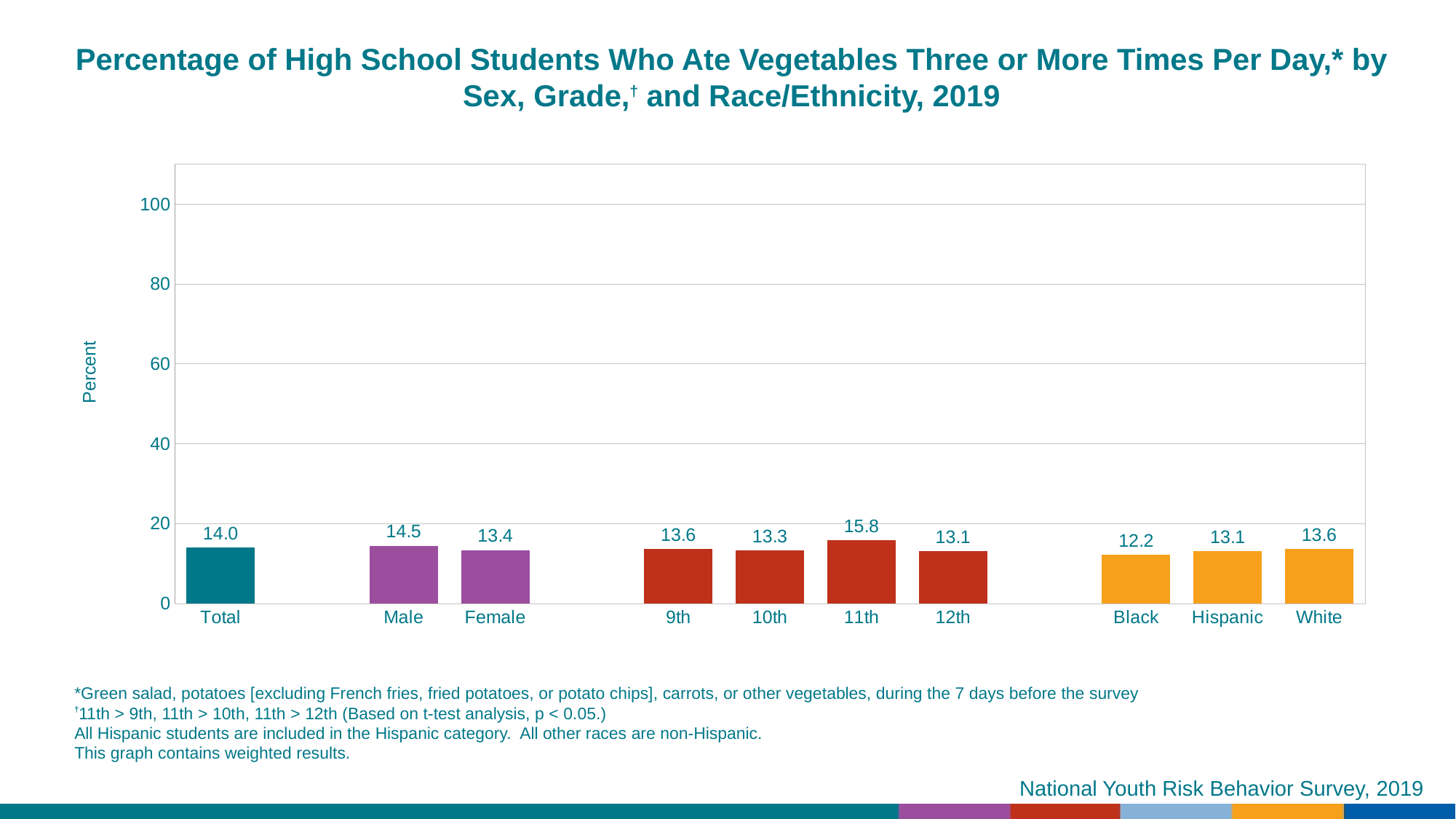
What is the value for Male? 14.5 Which category has the highest value? 11th How many categories are shown on the x axis? 10 What is the value for 11th grade? 15.8 Which category has the lowest value? Black What kind of chart is shown on the slide? bar chart Is the value for White students greater or less than 20? less Which is larger, the value for 9th grade or the value for 12th grade? 9th What is the difference between the Male and Female values? 1.1 What is the label of the y axis? Percent What is the value for Black students? 12.2 What is the value for Total? 14.0